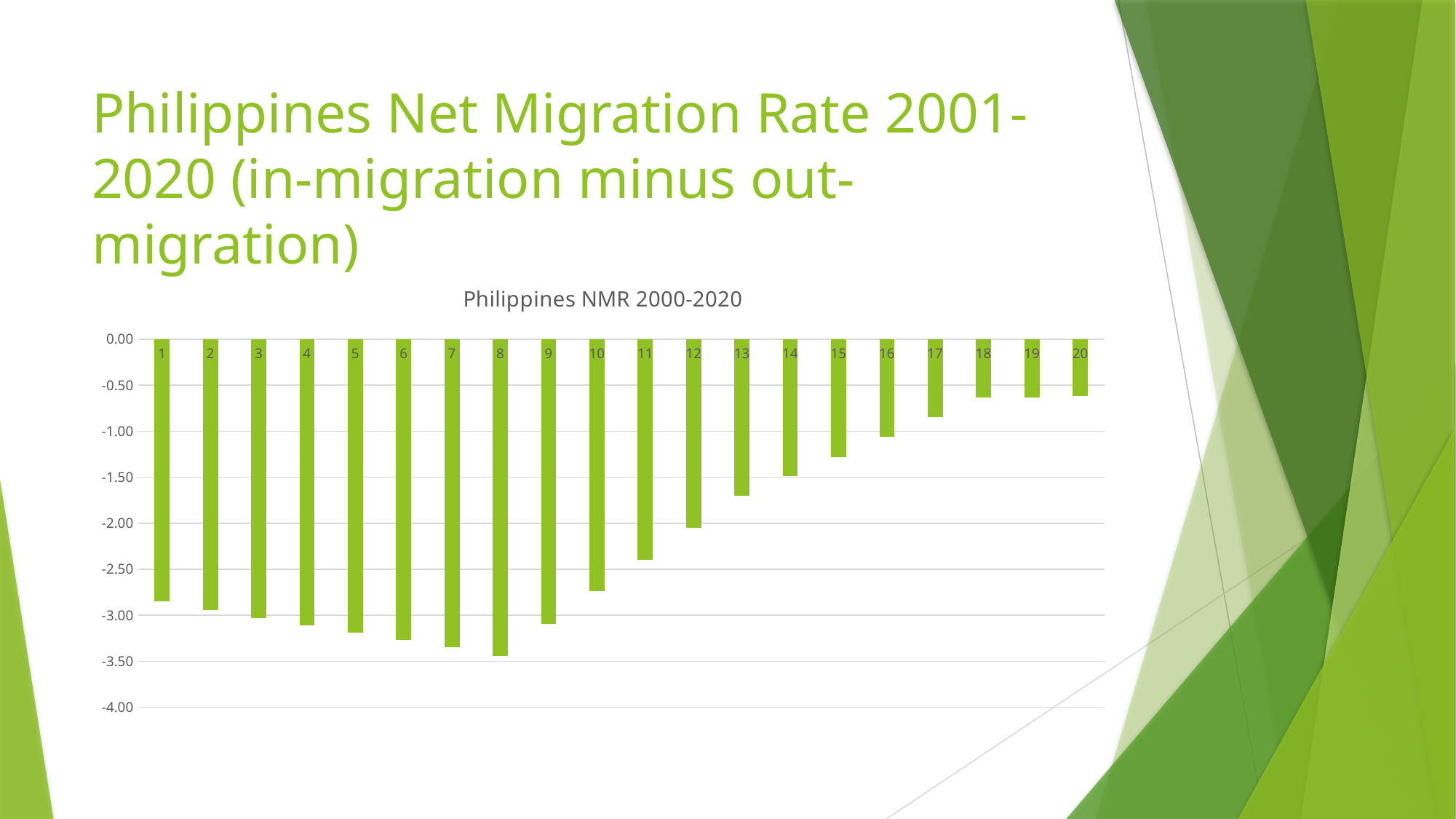
Is the value for category 17 greater or less than -1.00? greater Is the value for category 10 greater or less than -2.50? less Which has the lower value, category 8 or category 1? 8 Is the value for category 15 greater or less than -1.50? greater Which category has the lowest (most negative) value in the chart? 8 Which has the higher value, category 20 or category 10? 20 What kind of chart is shown on the slide? bar chart How many bars (categories) are plotted in the chart? 20 From category 8 to category 20, do the values rise or fall? rise What is the title printed above the chart? Philippines NMR 2000-2020